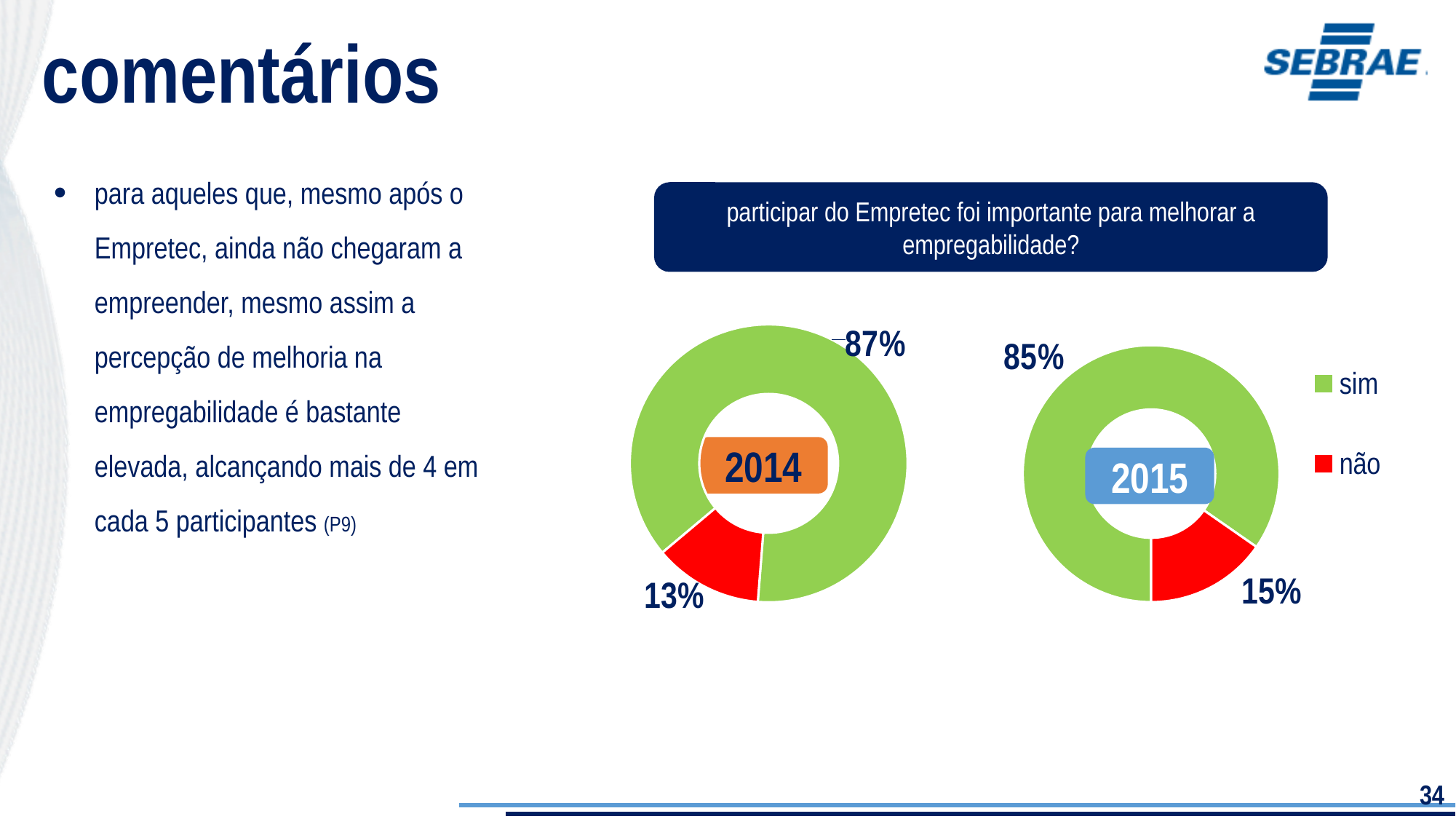
In the 2015 chart, what percentage answered "não"? 15% In the 2014 chart, what percentage answered "sim"? 87% What question do the two charts answer, according to the title box above them? participar do Empretec foi importante para melhorar a empregabilidade? In the 2015 chart, which category has the smallest share? não What is the difference between the "sim" share in 2014 and the "sim" share in 2015? 2 percentage points In the 2014 chart, which category has the largest share? sim In the 2014 chart, what percentage answered "não"? 13% What type of chart is used to show the 2014 and 2015 results? Donut (pie) chart In the 2015 chart, what percentage answered "sim"? 85% How many categories does the legend list for the charts? 2 Which is larger: the "não" share in the 2014 chart or the "não" share in the 2015 chart? 2015 What colour represents "não" in the charts? Red